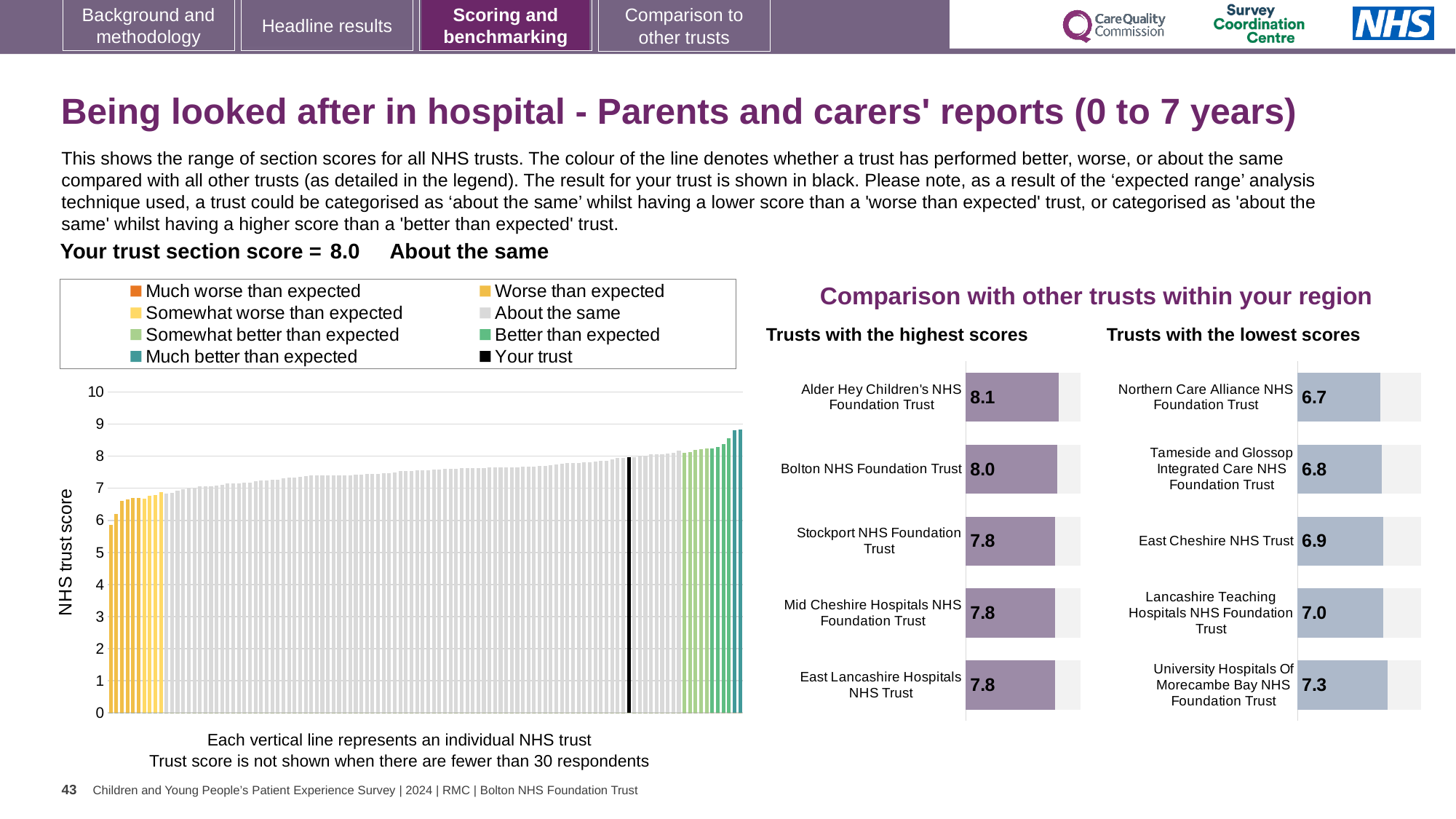
In the main chart on the left showing all NHS trusts, what is the section score for your trust (the black line)? 8.0 In the 'Trusts with the lowest scores' chart, which trust has the lowest score? Northern Care Alliance NHS Foundation Trust In the main chart on the left showing all NHS trusts, is the value of the lowest (leftmost) bar greater or less than 7? less How many trusts are listed in the 'Trusts with the lowest scores' chart? 5 In the 'Trusts with the lowest scores' chart, what is the score for East Cheshire NHS Trust? 6.9 In the 'Trusts with the highest scores' chart, which trust has the highest score? Alder Hey Children's NHS Foundation Trust How many entries does the legend of the main chart on the left list? 8 In the main chart on the left showing all NHS trusts, do the trust scores rise or fall from left to right? rise In the 'Trusts with the highest scores' chart, what is the score for Alder Hey Children's NHS Foundation Trust? 8.1 In the 'Trusts with the lowest scores' chart, what is the difference between the scores of University Hospitals Of Morecambe Bay NHS Foundation Trust and Northern Care Alliance NHS Foundation Trust? 0.6 In the 'Trusts with the highest scores' chart, which has the larger score: Bolton NHS Foundation Trust or Stockport NHS Foundation Trust? Bolton NHS Foundation Trust In the 'Trusts with the lowest scores' chart, what is the score for Northern Care Alliance NHS Foundation Trust? 6.7